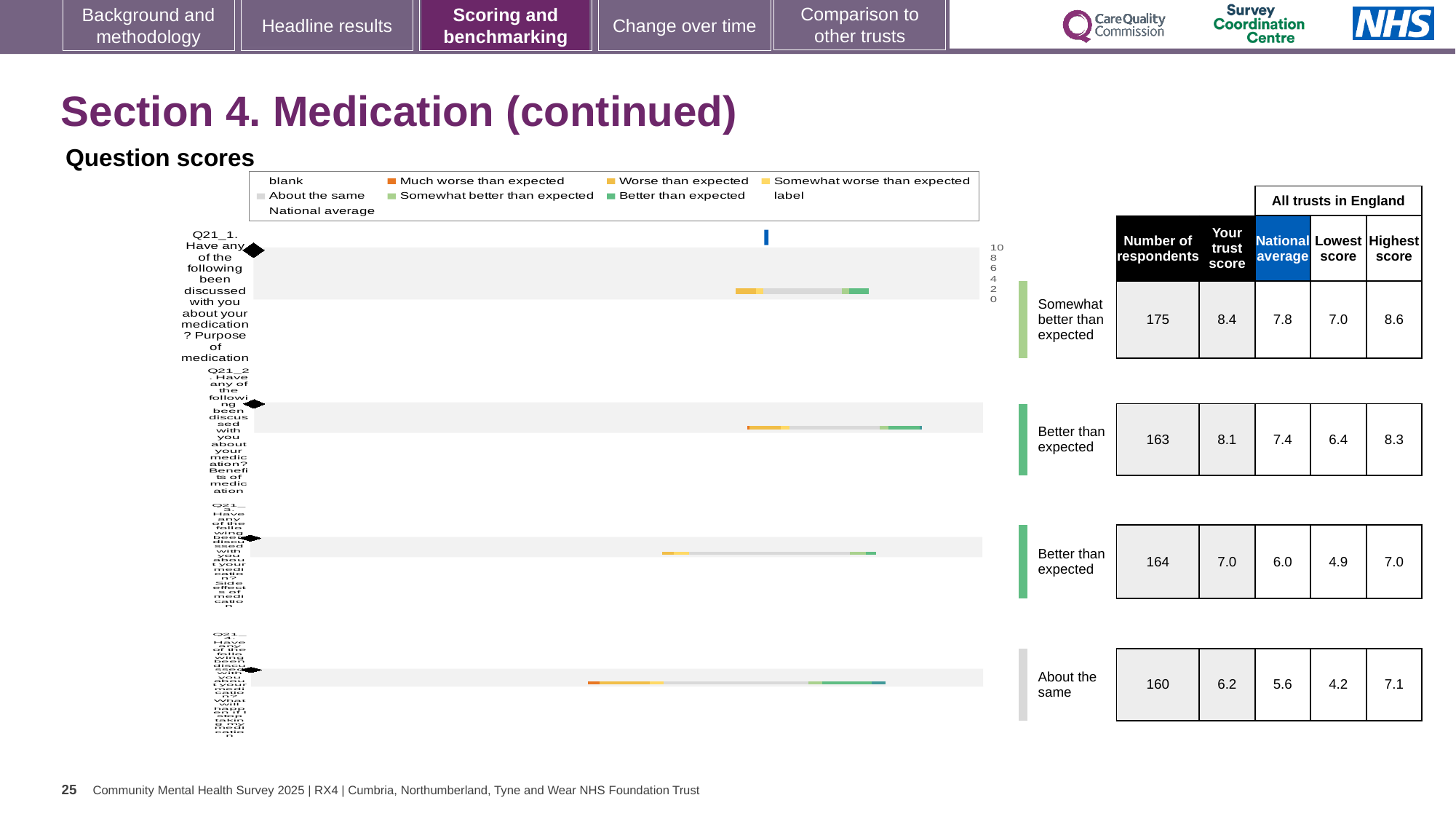
In the table beside the chart, which row has the lowest 'Your trust score'? Q21_4 (6.2) What kind of chart is shown under 'Question scores'? bar chart In the table beside the chart, what is the difference between 'Your trust score' and the national average for the third row (Q21_3)? 1.0 In the table beside the chart, is 'Your trust score' for Q21_1 larger or smaller than the national average for Q21_1? larger In the table beside the chart, what is 'Your trust score' for the second row (Q21_2)? 8.1 In the table beside the chart, which row has the highest 'Your trust score'? Q21_1 (8.4) How many entries does the chart legend list? 9 Which legend entry is shown in orange? Much worse than expected How many question bars are plotted in the chart? 4 What is the label of the first (top) bar in the chart? Q21_1. Have any of the following been discussed with you about your medication? Purpose of medication In the table beside the chart, what is the number of respondents for the first row (Q21_1)? 175 In the table beside the chart, what is the national average for the fourth row (Q21_4)? 5.6